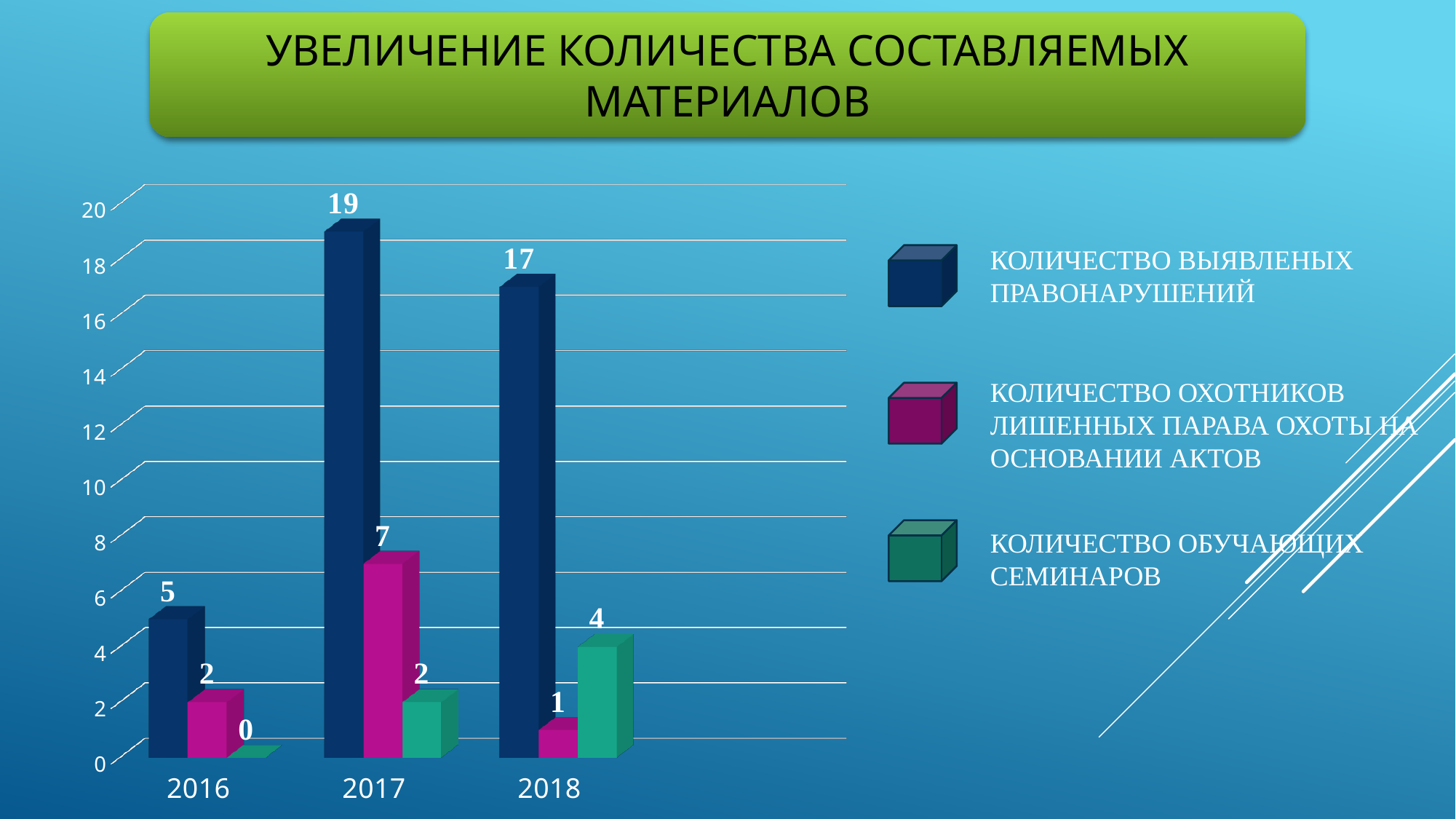
What is the value for 'КОЛИЧЕСТВО ВЫЯВЛЕНЫХ ПРАВОНАРУШЕНИЙ' in 2017? 19 In which year is 'КОЛИЧЕСТВО ВЫЯВЛЕНЫХ ПРАВОНАРУШЕНИЙ' highest? 2017 How many years are shown on the x axis? 3 What kind of chart is shown on the slide? bar chart Does 'КОЛИЧЕСТВО ОБУЧАЮЩИХ СЕМИНАРОВ' rise or fall from 2016 to 2018? rise How many series does the legend list? 3 Which is larger: 'КОЛИЧЕСТВО ОБУЧАЮЩИХ СЕМИНАРОВ' in 2018 or 'КОЛИЧЕСТВО ОХОТНИКОВ ЛИШЕННЫХ ПАРАВА ОХОТЫ НА ОСНОВАНИИ АКТОВ' in 2018? КОЛИЧЕСТВО ОБУЧАЮЩИХ СЕМИНАРОВ What is the value for 'КОЛИЧЕСТВО ОБУЧАЮЩИХ СЕМИНАРОВ' in 2016? 0 What is the difference between 'КОЛИЧЕСТВО ВЫЯВЛЕНЫХ ПРАВОНАРУШЕНИЙ' in 2017 and in 2016? 14 Is the value for 'КОЛИЧЕСТВО ВЫЯВЛЕНЫХ ПРАВОНАРУШЕНИЙ' in 2018 greater or less than 10? greater What is the value for 'КОЛИЧЕСТВО ОХОТНИКОВ ЛИШЕННЫХ ПАРАВА ОХОТЫ НА ОСНОВАНИИ АКТОВ' in 2018? 1 In which year is 'КОЛИЧЕСТВО ОХОТНИКОВ ЛИШЕННЫХ ПАРАВА ОХОТЫ НА ОСНОВАНИИ АКТОВ' lowest? 2018